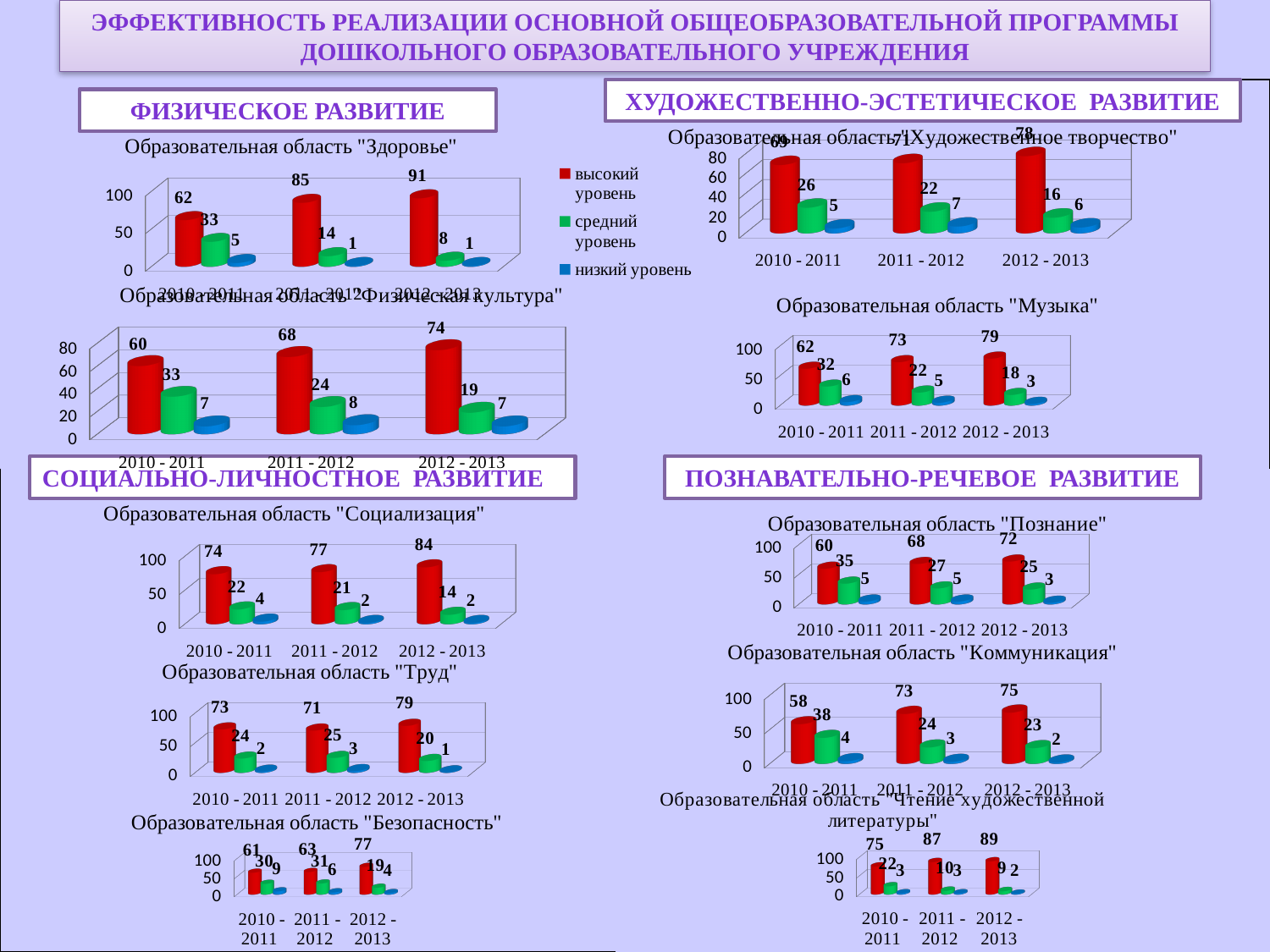
In the chart "Образовательная область "Труд"", which year has the lowest value for the высокий уровень series? 2011 - 2012 In the chart "Образовательная область "Коммуникация"", what is the difference between the высокий уровень values for 2012 - 2013 and 2010 - 2011? 17 In the chart "Образовательная область "Здоровье"", what is the value of the высокий уровень series for 2012 - 2013? 91 Which colour represents the низкий уровень series in the legend? blue In the chart "Образовательная область "Чтение художественной литературы"", does the высокий уровень series rise or fall from 2010 - 2011 to 2012 - 2013? rise In the chart "Образовательная область "Художественное творчество"", what is the value of the низкий уровень series for 2011 - 2012? 7 How many year categories are shown on the x axis of the chart "Образовательная область "Познание""? 3 How many series does the legend next to the "Здоровье" chart list? 3 In the chart "Образовательная область "Музыка"", which year has the highest value for the высокий уровень series? 2012 - 2013 In the chart "Образовательная область "Социализация"", is the средний уровень value for 2010 - 2011 larger or smaller than the средний уровень value for 2012 - 2013? larger In the chart "Образовательная область "Физическая культура"", what is the value of the средний уровень series for 2011 - 2012? 24 What kind of chart is "Образовательная область "Безопасность""? bar chart